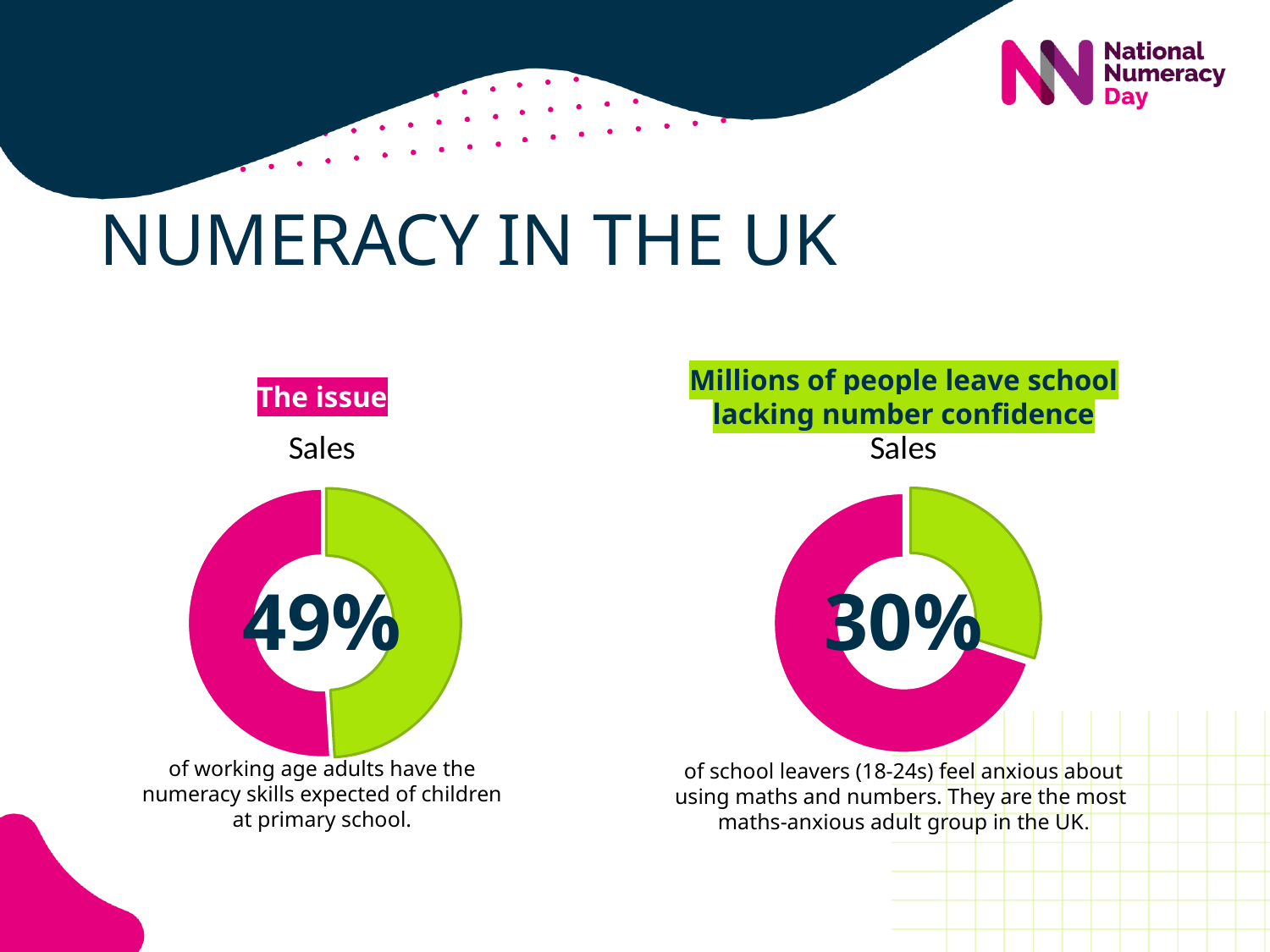
Which chart shows the larger percentage in its centre, the left chart or the right chart? Left chart What kind of chart is the left chart on the slide? Doughnut chart How many slices does the left doughnut chart have? 2 How many slices does the right doughnut chart have? 2 In the right chart, is the green slice's share greater or less than 50%? less What is the title shown above the right chart? Sales What kind of chart is the right chart on the slide? Doughnut chart What percentage is printed in the centre of the right chart? 30% How many charts are shown on the slide? 2 In the right chart, which slice is larger, the pink one or the green one? Pink What is the title shown above the left chart? Sales What percentage is printed in the centre of the left chart? 49%